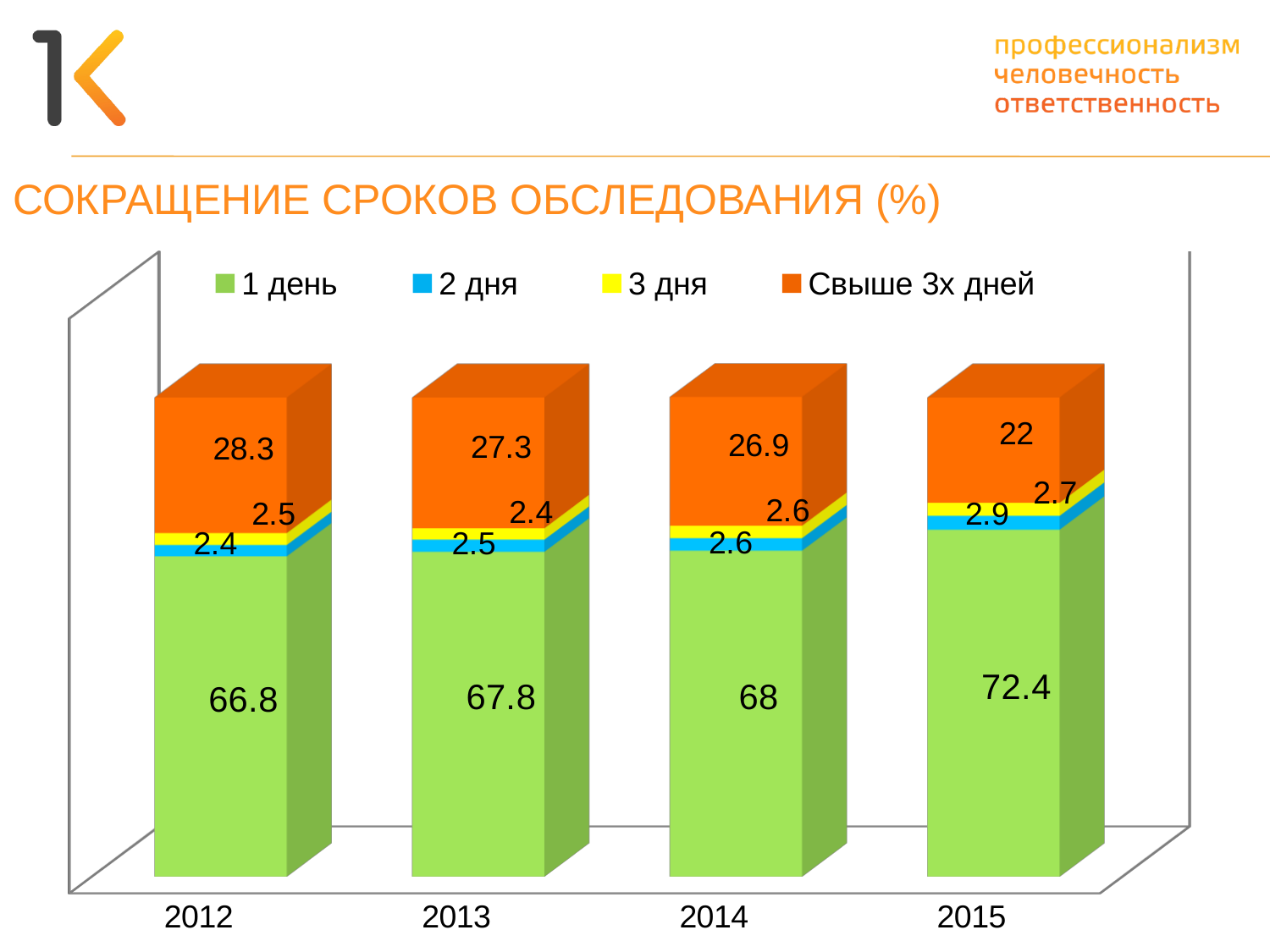
What is the difference between the "1 день" values for 2015 and 2012? 5.6 How many series does the legend list? 4 In which year is the value for "1 день" highest? 2015 How many years are shown on the x axis? 4 Does the value for "Свыше 3х дней" rise or fall from 2012 to 2015? Fall What is the value for "3 дня" in 2013? 2.4 What kind of chart is shown on the slide? Stacked bar chart What is the value for "2 дня" in 2014? 2.6 In which year is the value for "Свыше 3х дней" lowest? 2015 What is the value for "1 день" in 2015? 72.4 What is the value for "Свыше 3х дней" in 2012? 28.3 Which is larger: the "Свыше 3х дней" value for 2013 or for 2014? 2013